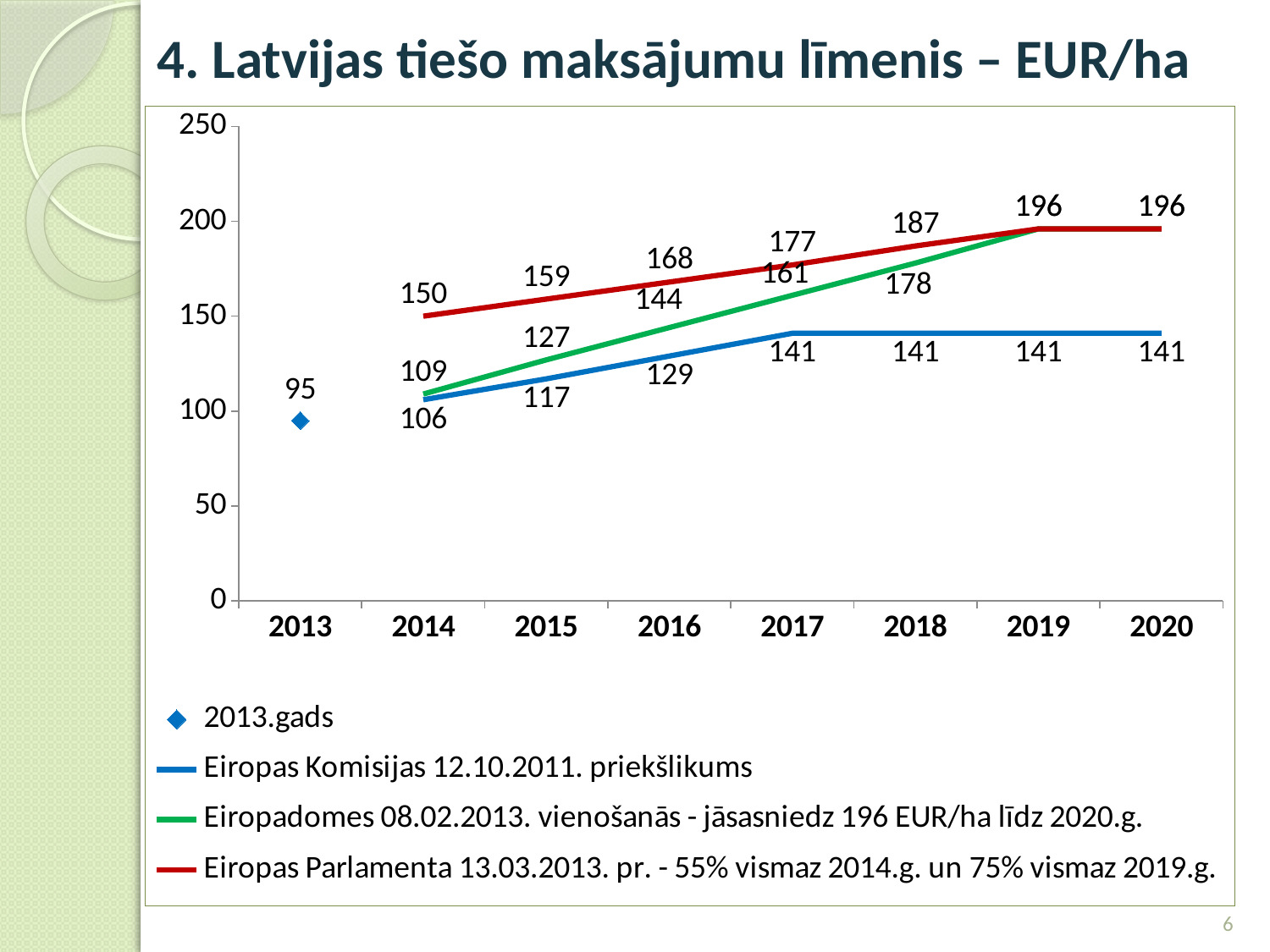
How many years are shown on the x axis? 8 Which is larger in 2016: the Eiropadomes 08.02.2013. vienošanās value or the Eiropas Komisijas 12.10.2011. priekšlikums value? Eiropadomes 08.02.2013. vienošanās What is the difference between the Eiropas Parlamenta series and the Eiropas Komisijas series in 2020? 55 What is the value of the Eiropas Parlamenta 13.03.2013. pr. series in 2014? 150 What is the value for 2013 (2013.gads)? 95 What is the value of the Eiropas Komisijas 12.10.2011. priekšlikums series in 2016? 129 Which series has the lowest value in 2017? Eiropas Komisijas 12.10.2011. priekšlikums How many series does the legend list? 4 Does the Eiropadomes 08.02.2013. vienošanās series rise or fall from 2014 to 2019? Rise What is the value of the Eiropadomes 08.02.2013. vienošanās series in 2018? 178 Which series has the highest value in 2015? Eiropas Parlamenta 13.03.2013. pr. What kind of chart is shown on the slide? Line chart